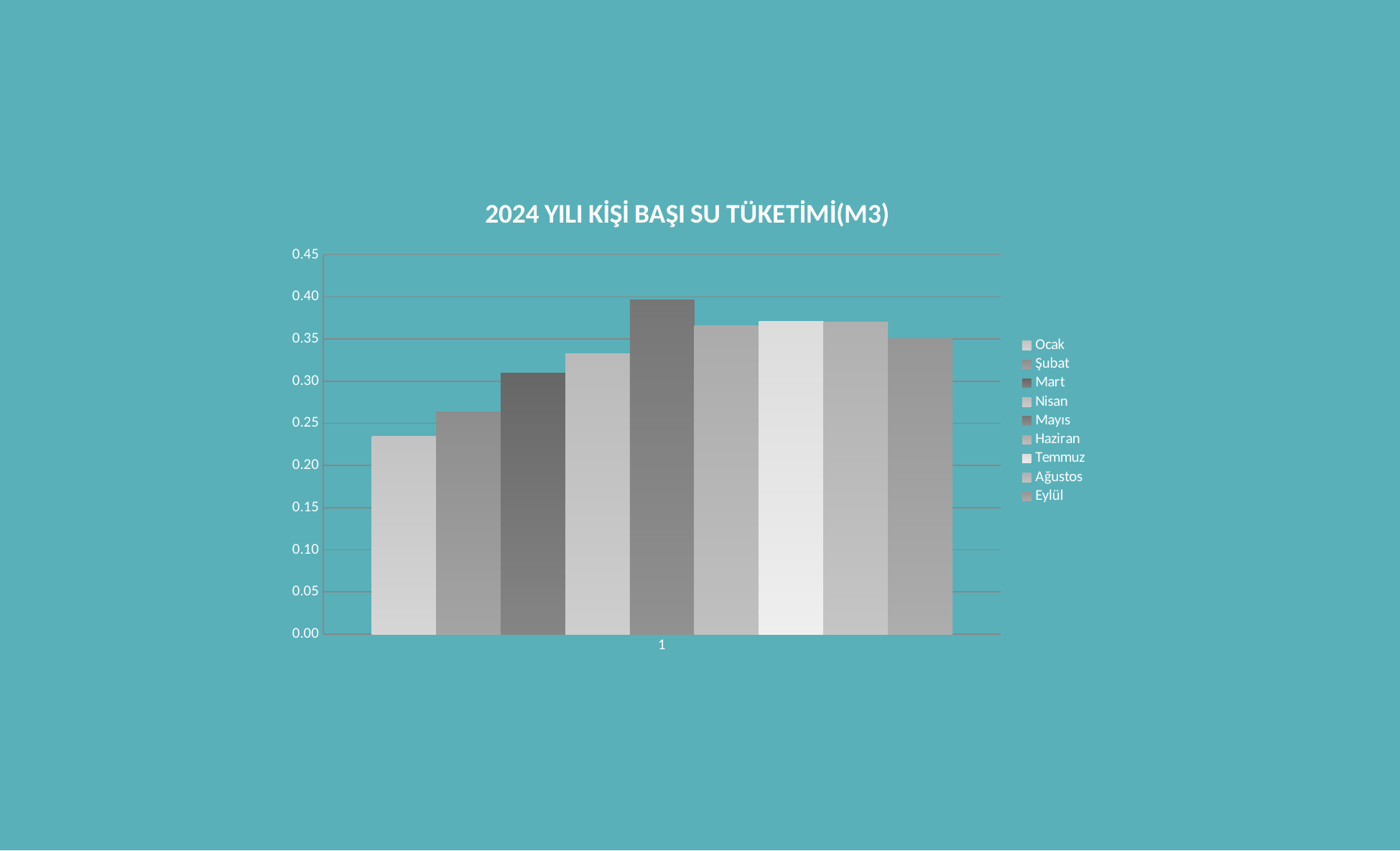
Do the values rise or fall from Ocak to Mayıs? rise Is the value for Mart greater or less than 0.30? greater How many series does the legend list? 9 What kind of chart is shown on the slide? bar chart Which is larger, the value for Mart or the value for Şubat? Mart Is the value for Ocak greater or less than 0.25? less Is the value for Şubat greater or less than 0.30? less Which month has the highest per-capita water consumption? Mayıs Which is larger, the value for Mayıs or the value for Temmuz? Mayıs What is the title of the chart? 2024 YILI KİŞİ BAŞI SU TÜKETİMİ(M3) Which month has the lowest per-capita water consumption? Ocak